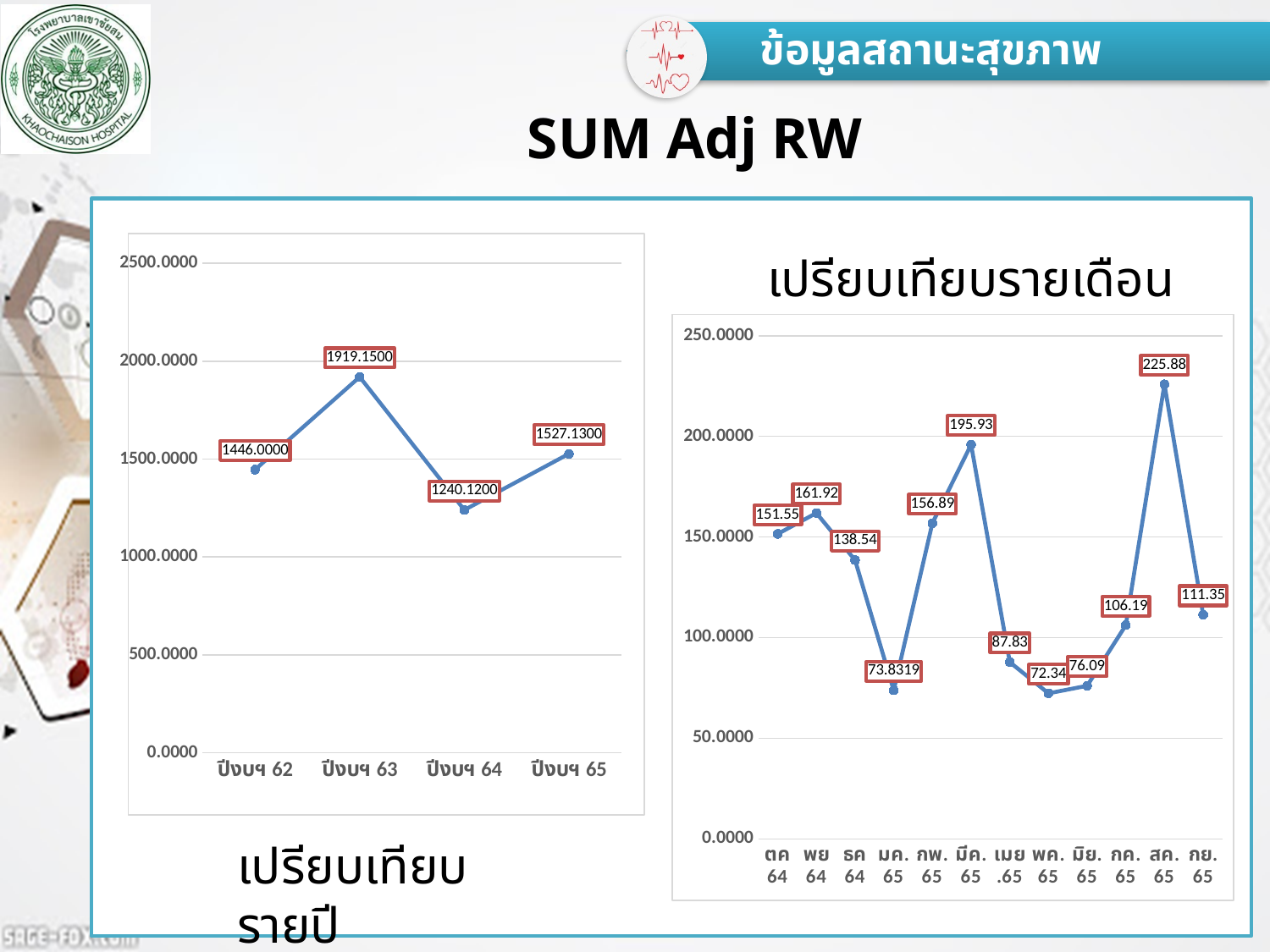
In the left chart (เปรียบเทียบรายปี), how many fiscal years are plotted? 4 In the left chart (เปรียบเทียบรายปี), what is the difference between the values for ปีงบฯ 63 and ปีงบฯ 62? 473.1500 In the left chart (เปรียบเทียบรายปี), what is the value for ปีงบฯ 63? 1919.1500 In the left chart (เปรียบเทียบรายปี), which fiscal year has the lowest value? ปีงบฯ 64 In the right chart (เปรียบเทียบรายเดือน), which month has the lowest value? พค. 65 What kind of chart is the left chart (เปรียบเทียบรายปี)? Line chart In the right chart (เปรียบเทียบรายเดือน), which is larger, the value for ตค 64 or the value for พย 64? พย 64 In the right chart (เปรียบเทียบรายเดือน), which month has the highest value? สค. 65 In the right chart (เปรียบเทียบรายเดือน), how many months are plotted? 12 In the right chart (เปรียบเทียบรายเดือน), what is the difference between the values for สค. 65 and กย. 65? 114.53 In the right chart (เปรียบเทียบรายเดือน), is the value for กค. 65 greater or less than 100.0000? greater In the right chart (เปรียบเทียบรายเดือน), what is the value for มีค. 65? 195.93